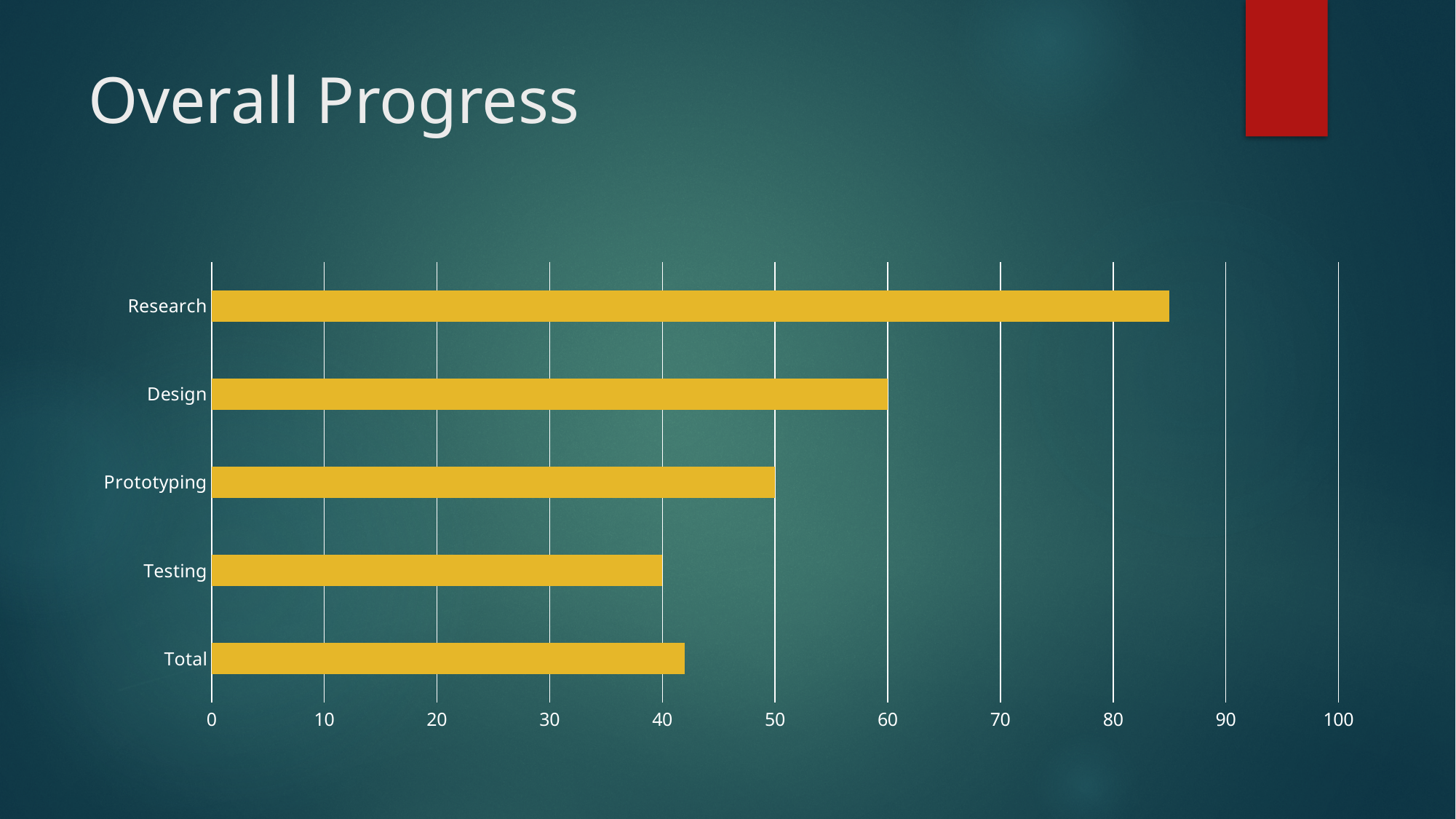
What is the difference between the values for Design and Prototyping? 10 Is the value for Research greater or less than 80? greater What colour are the bars in the chart? yellow What is the value for Testing? 40 What is the value for Design? 60 What type of chart is shown on the slide? bar chart What is the value for Prototyping? 50 Which category has the highest value? Research Which is larger, the value for Research or the value for Design? Research How many categories are plotted in the chart? 5 Is the value for Total greater or less than 50? less What is the title of the chart on the slide? Overall Progress